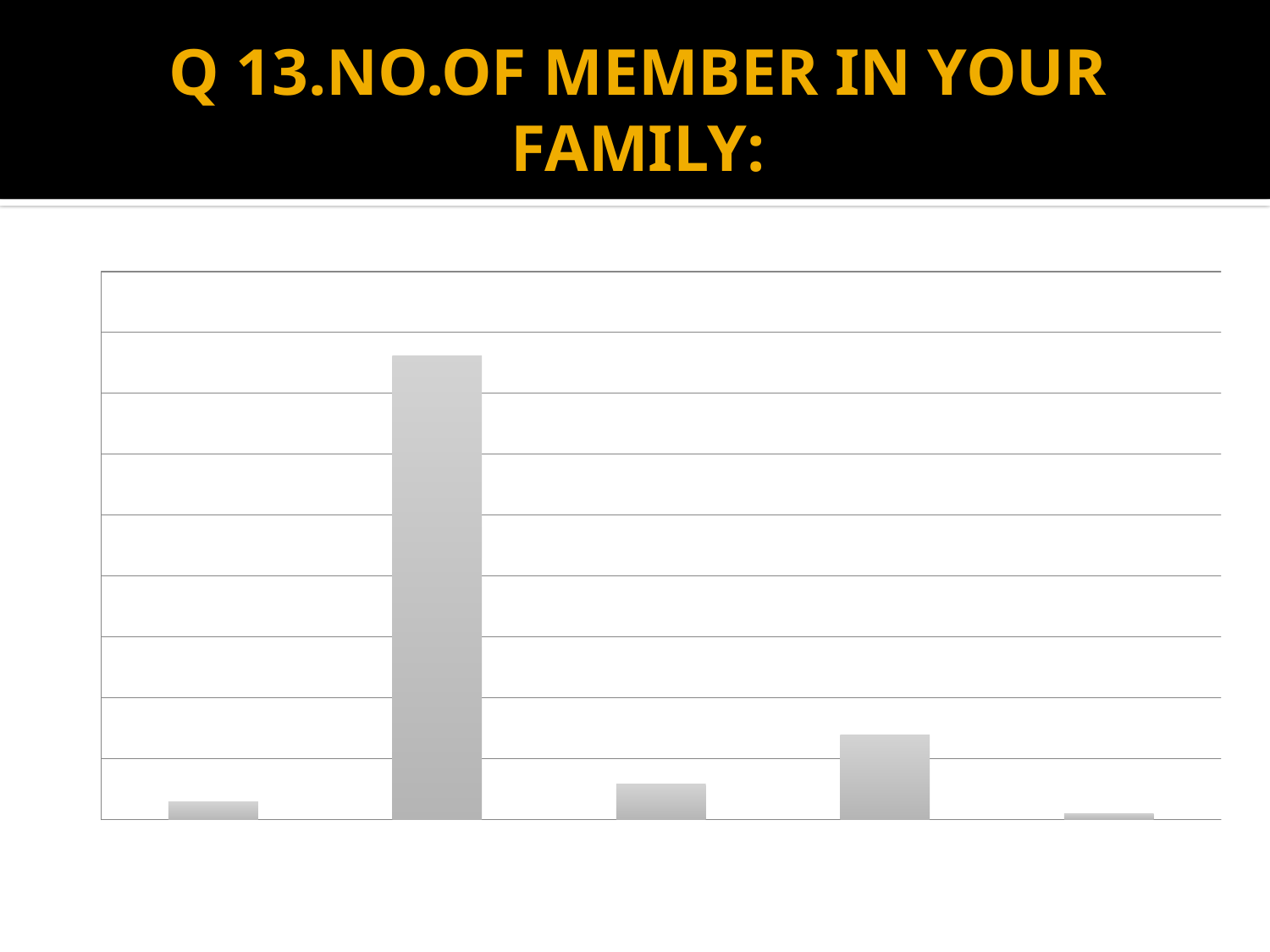
Which is taller, the third bar or the fourth bar from the left? the fourth bar What colour are the bars in the chart? grey Which bar, counting from the left, is the tallest in the chart? the second bar Which is taller, the fourth bar or the fifth bar from the left? the fourth bar Which is taller, the first bar or the second bar from the left? the second bar What is the title of the slide containing the chart? Q 13.NO.OF MEMBER IN YOUR FAMILY: How many bars are plotted in the chart? 5 Which bar, counting from the left, is the shortest in the chart? the fifth bar What kind of chart is shown on the slide? bar chart